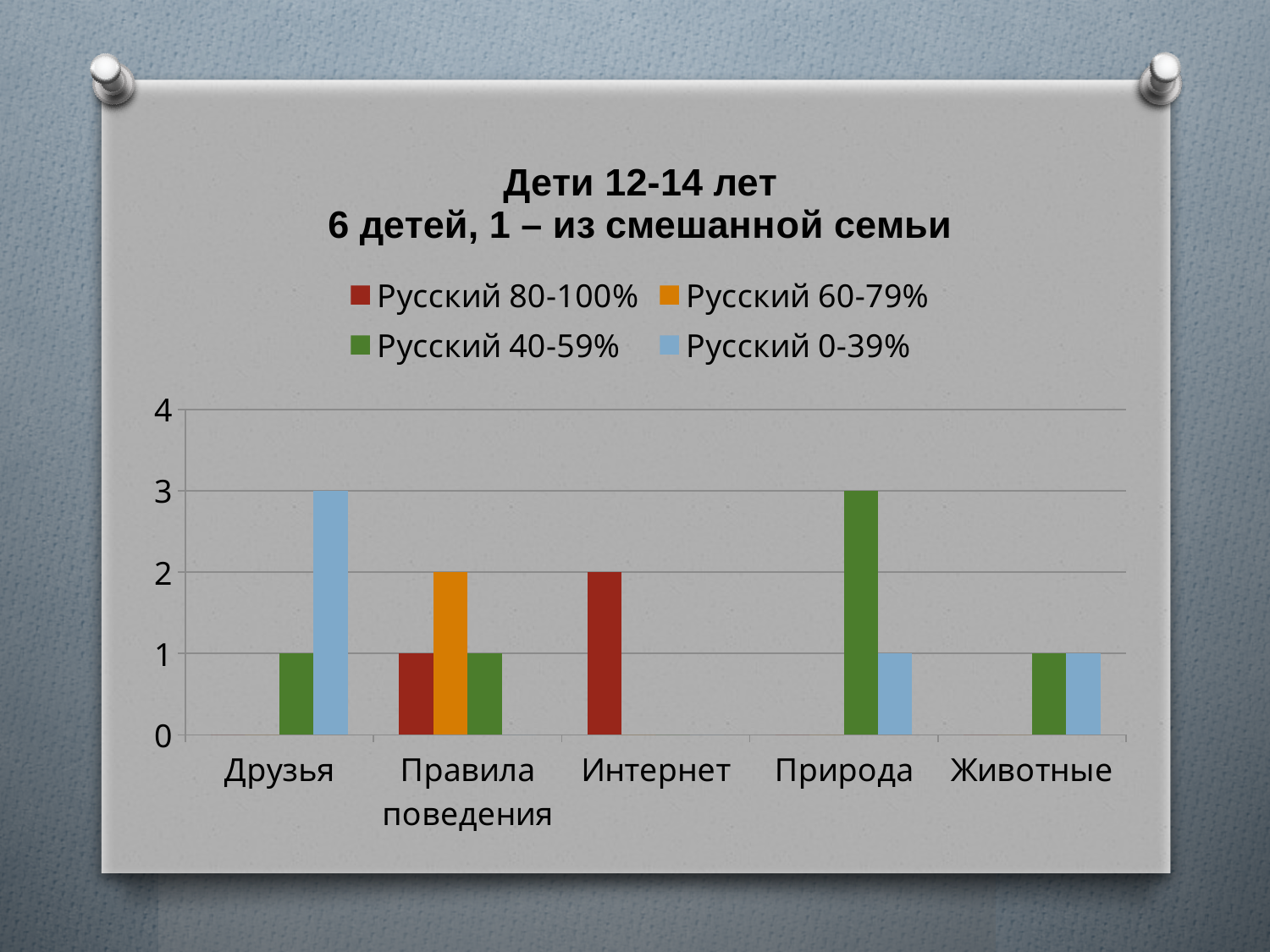
Which is larger in the Правила поведения category: the value for Русский 60-79% or the value for Русский 80-100%? Русский 60-79% What is the value for Русский 60-79% in the Правила поведения category? 2 Which category has the highest value for Русский 0-39%? Друзья What is the value for Русский 80-100% in the Интернет category? 2 What is the difference between the Русский 0-39% value for Друзья and the Русский 0-39% value for Животные? 2 How many categories are shown along the x axis? 5 What is the value for Русский 40-59% in the Природа category? 3 Which category has the highest value for Русский 40-59%? Природа How many series does the legend list? 4 What kind of chart is shown on the slide? Bar chart What is the title of the chart? Дети 12-14 лет 6 детей, 1 – из смешанной семьи What is the value for Русский 0-39% in the Друзья category? 3